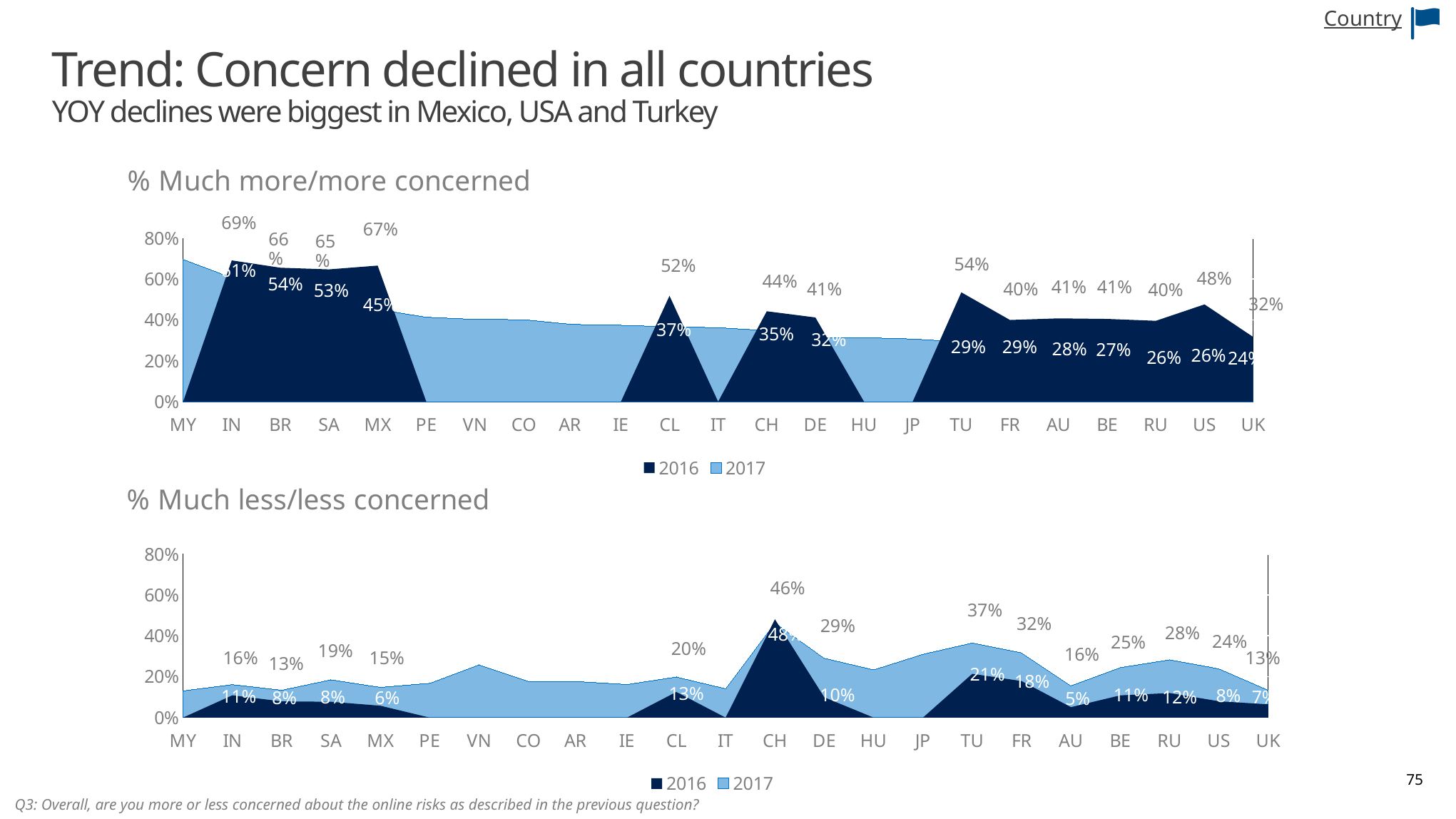
In the top chart '% Much more/more concerned', which is larger: the 2016 value for US or the 2016 value for FR? US In the top chart '% Much more/more concerned', is the 2017 value for CO greater or less than 60%? less In the bottom chart '% Much less/less concerned', what is the 2016 value for AU? 5% In the top chart '% Much more/more concerned', what is the difference between the 2016 and 2017 values for MX? 22 percentage points In the top chart '% Much more/more concerned', what is the 2016 value for TU? 54% What kind of chart is the top chart titled '% Much more/more concerned'? area chart How many countries are shown along the x axis of the bottom chart '% Much less/less concerned'? 23 In the top chart '% Much more/more concerned', what is the 2017 value for UK? 24% In the bottom chart '% Much less/less concerned', what is the 2017 value for TU? 37% In the bottom chart '% Much less/less concerned', which country has the highest 2016 value? CH How many series does the legend of the top chart list? 2 In the top chart '% Much more/more concerned', which country has the highest 2016 value? IN